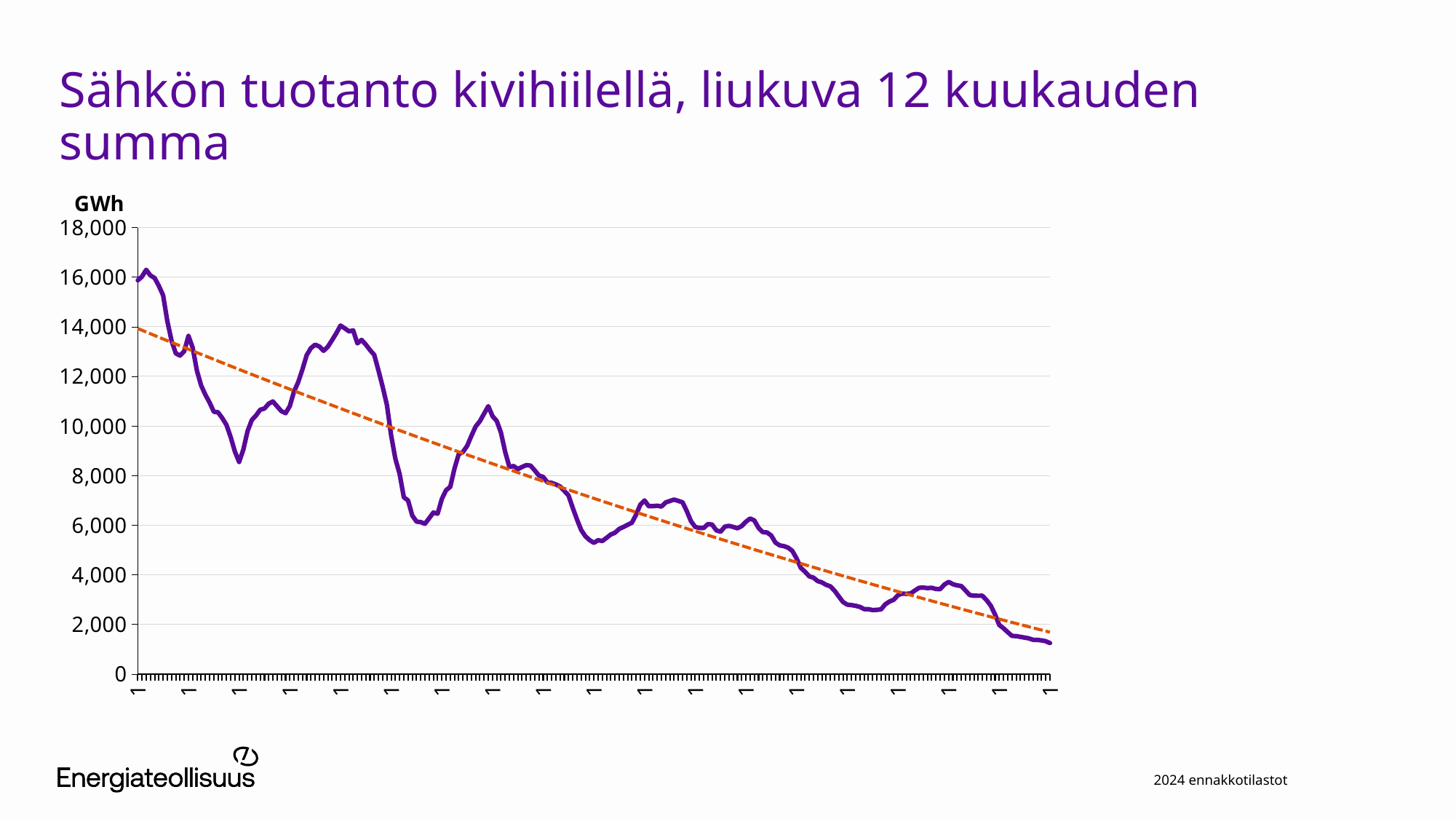
Is the orange dashed line at the left end of the chart greater or less than 12,000? greater Is the orange dashed line at the right end of the chart greater or less than 4,000? less Do the values of the purple line generally rise or fall from left to right along the x axis? fall Which is larger, the value of the purple line at the left end of the chart or at the right end? left end At which end of the chart, left or right, does the purple line reach its lowest value? right end What is the title of the chart? Sähkön tuotanto kivihiilellä, liukuva 12 kuukauden summa What kind of chart is shown on the slide? line chart Is the highest point of the purple line greater or less than 18,000? less What unit is shown at the top of the y axis? GWh